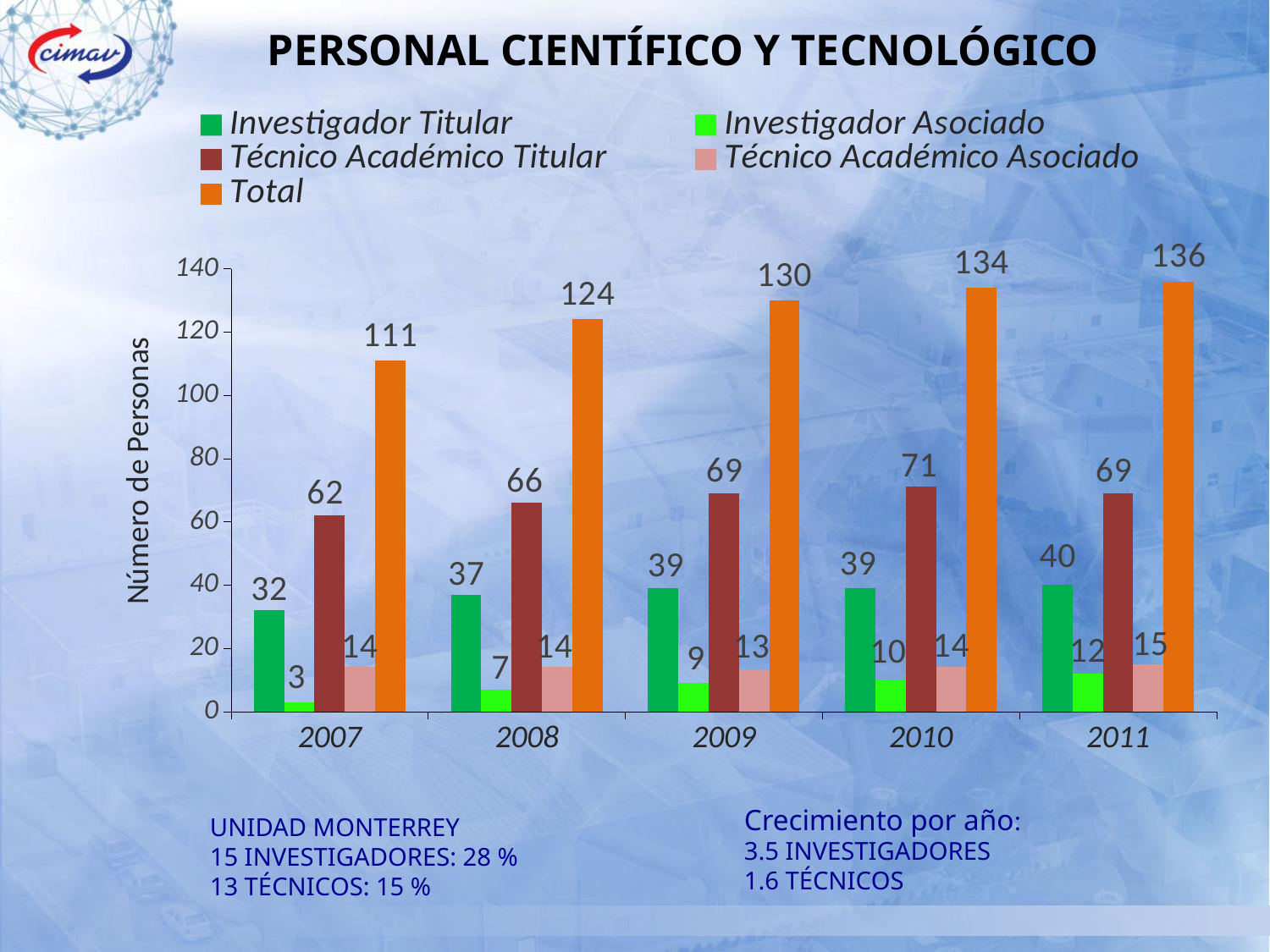
What is the value of Técnico Académico Titular for 2010? 71 What is the difference between the Total for 2011 and the Total for 2007? 25 In which year is Investigador Asociado lowest? 2007 How many series does the legend list? 5 What is the value of Total for 2009? 130 Which is larger, Técnico Académico Titular in 2008 or Técnico Académico Titular in 2009? 2009 Does the Total rise or fall from 2007 to 2011? rise What kind of chart is shown on the slide? bar chart What is the value of Investigador Asociado for 2007? 3 In which year is the Total highest? 2011 How many years are shown on the x axis? 5 What is the value of Investigador Titular for 2011? 40